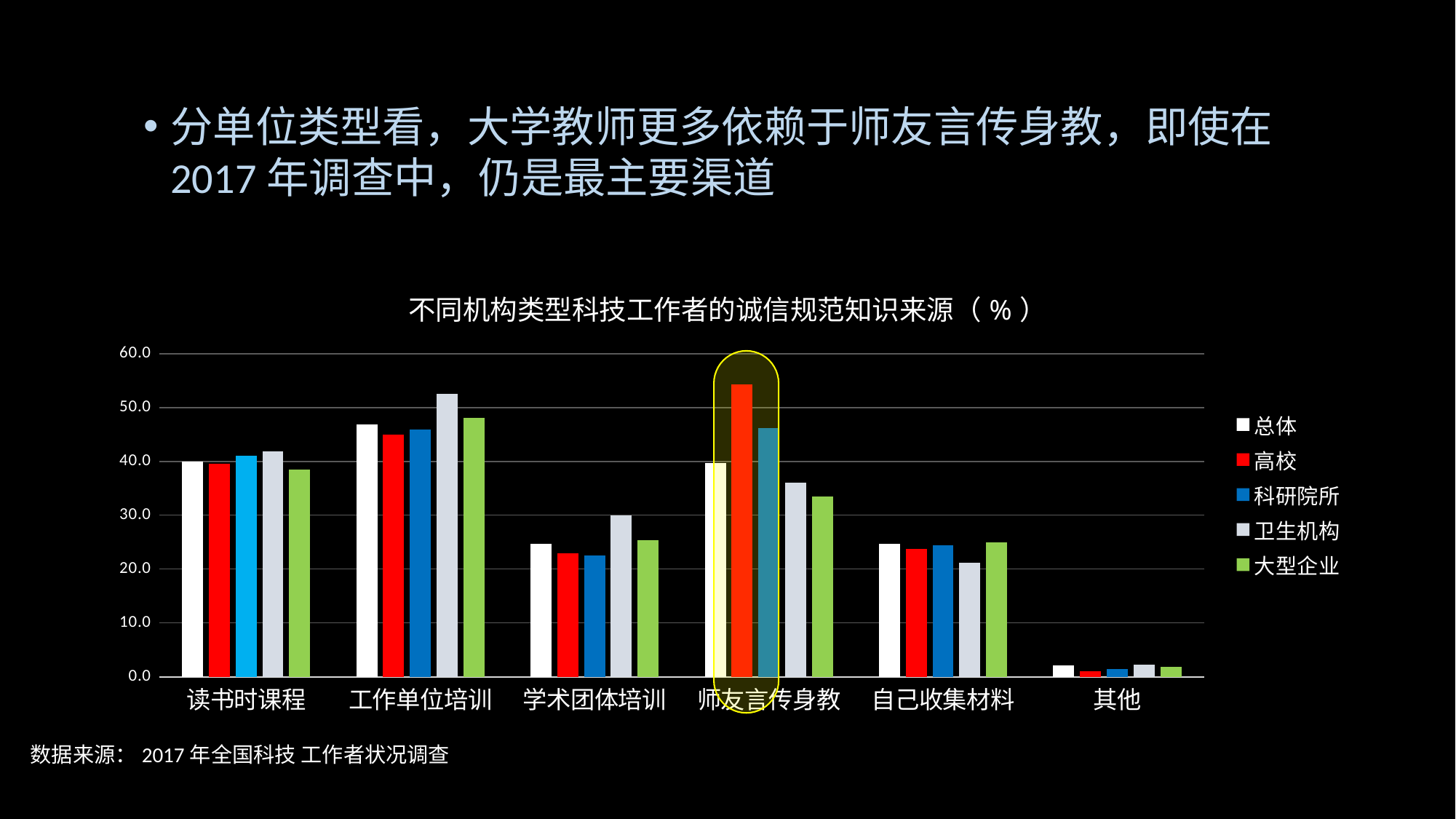
In the 师友言传身教 category, which is larger: 高校 or 大型企业? 高校 What kind of chart is shown on the slide? bar chart How many categories are shown on the x axis of the chart? 6 For the 卫生机构 series, which category has the highest value? 工作单位培训 In the 工作单位培训 category, which is larger: 卫生机构 or 高校? 卫生机构 For the 总体 series, which category has the lowest value? 其他 Is the value for 卫生机构 in the 自己收集材料 category greater or less than 30.0? less Is the value for 大型企业 in the 师友言传身教 category greater or less than 30.0? greater For the 高校 series, which category has the highest value? 师友言传身教 Which category on the chart is highlighted with a yellow outline? 师友言传身教 Is the value for 高校 in the 师友言传身教 category greater or less than 50.0? greater How many series does the chart's legend list? 5